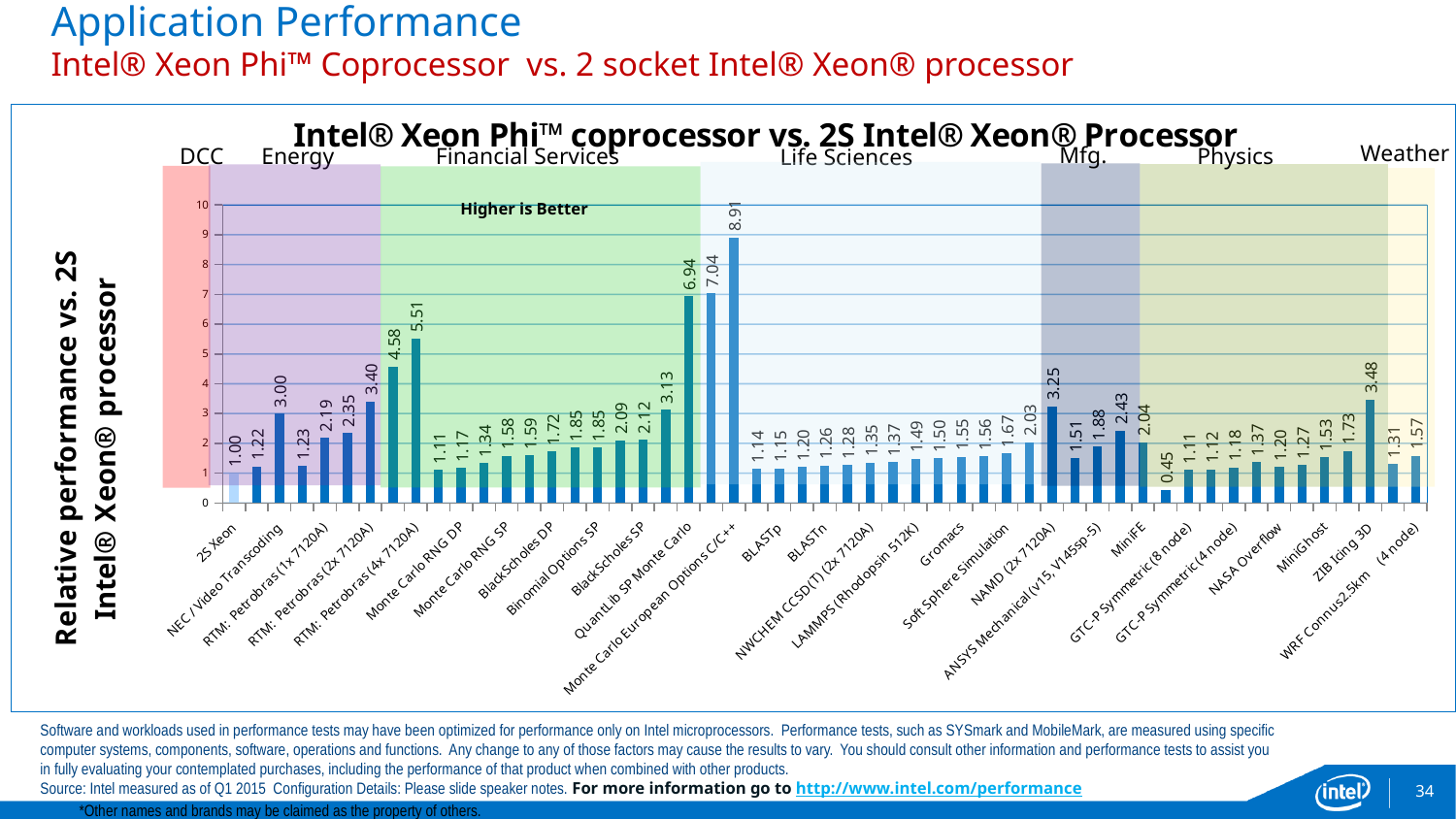
What is the highest relative performance value shown in the chart? 8.91 What kind of chart is shown on the slide? bar chart Which is larger, the bar labeled 8.91 or the bar labeled 7.04? 8.91 Is the bar for 2S Xeon greater or less than 2 on the y axis? less Is the tallest bar in the chart greater or less than 8 on the y axis? greater What is the difference between the highest value (8.91) and the lowest value (0.45) in the chart? 8.46 What is the relative performance value for 2S Xeon? 1.00 How many application segments (DCC, Energy, Financial Services, etc.) are labeled across the top of the chart? 7 What is the lowest relative performance value shown in the chart? 0.45 What annotation appears inside the chart area near the top of the Financial Services segment? Higher is Better What is the title of the chart? Intel® Xeon Phi™ coprocessor vs. 2S Intel® Xeon® Processor What is the difference between the two tallest bars, 8.91 and 7.04? 1.87